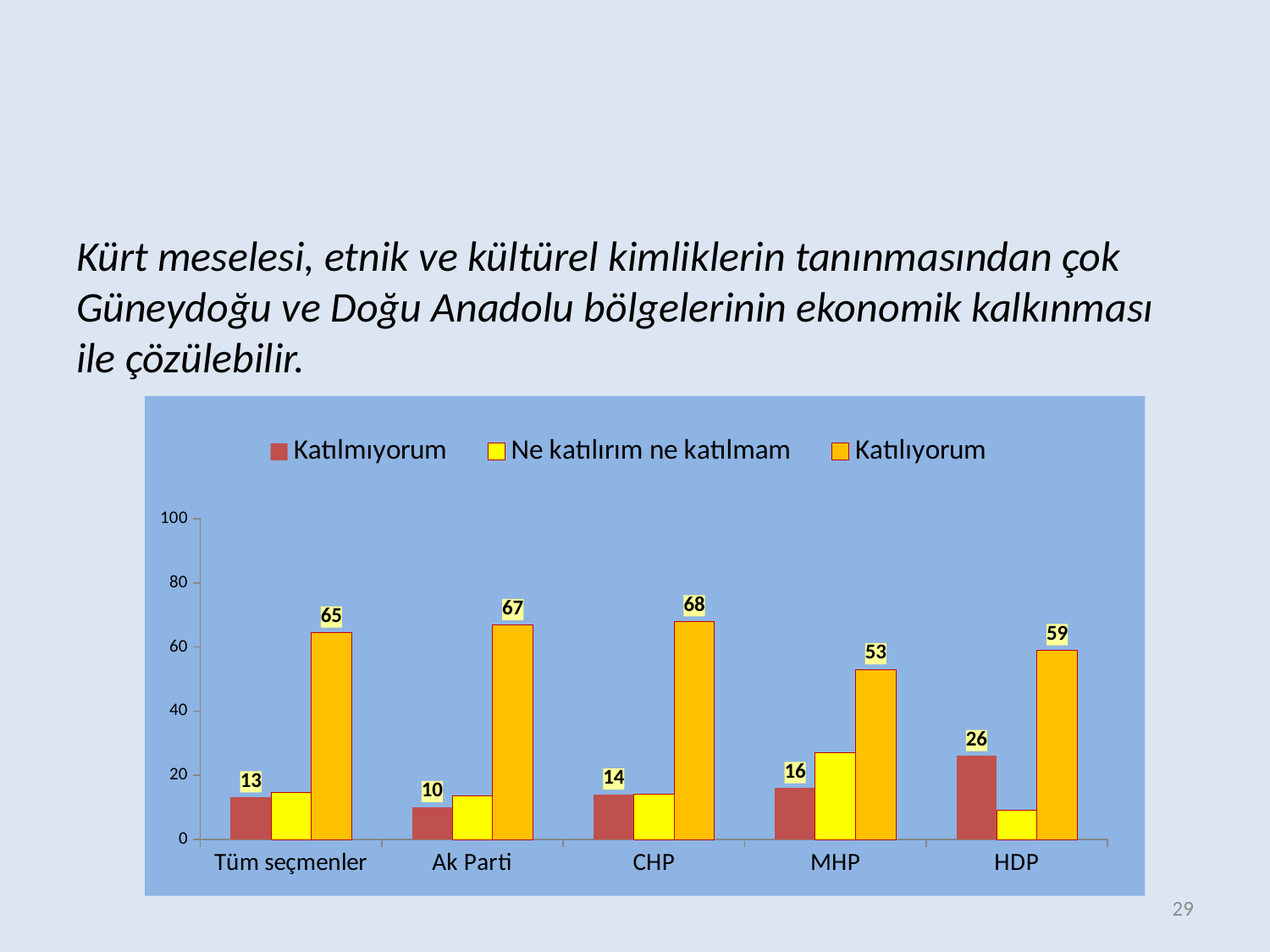
Which category has the highest Katılıyorum value? CHP Is the Ne katılırım ne katılmam value for MHP greater or less than 20? greater What is the Katılmıyorum value for HDP? 26 What is the Katılıyorum value for Tüm seçmenler? 65 What is the Katılıyorum value for CHP? 68 Which category has the lowest Katılmıyorum value? Ak Parti What is the difference between the Katılıyorum values for Ak Parti and MHP? 14 Which is larger, the Katılmıyorum value for MHP or for HDP? HDP How many categories are shown on the x axis? 5 Is the Ne katılırım ne katılmam value for HDP greater or less than 20? less What kind of chart is shown on the slide? Bar chart How many series does the legend list? 3